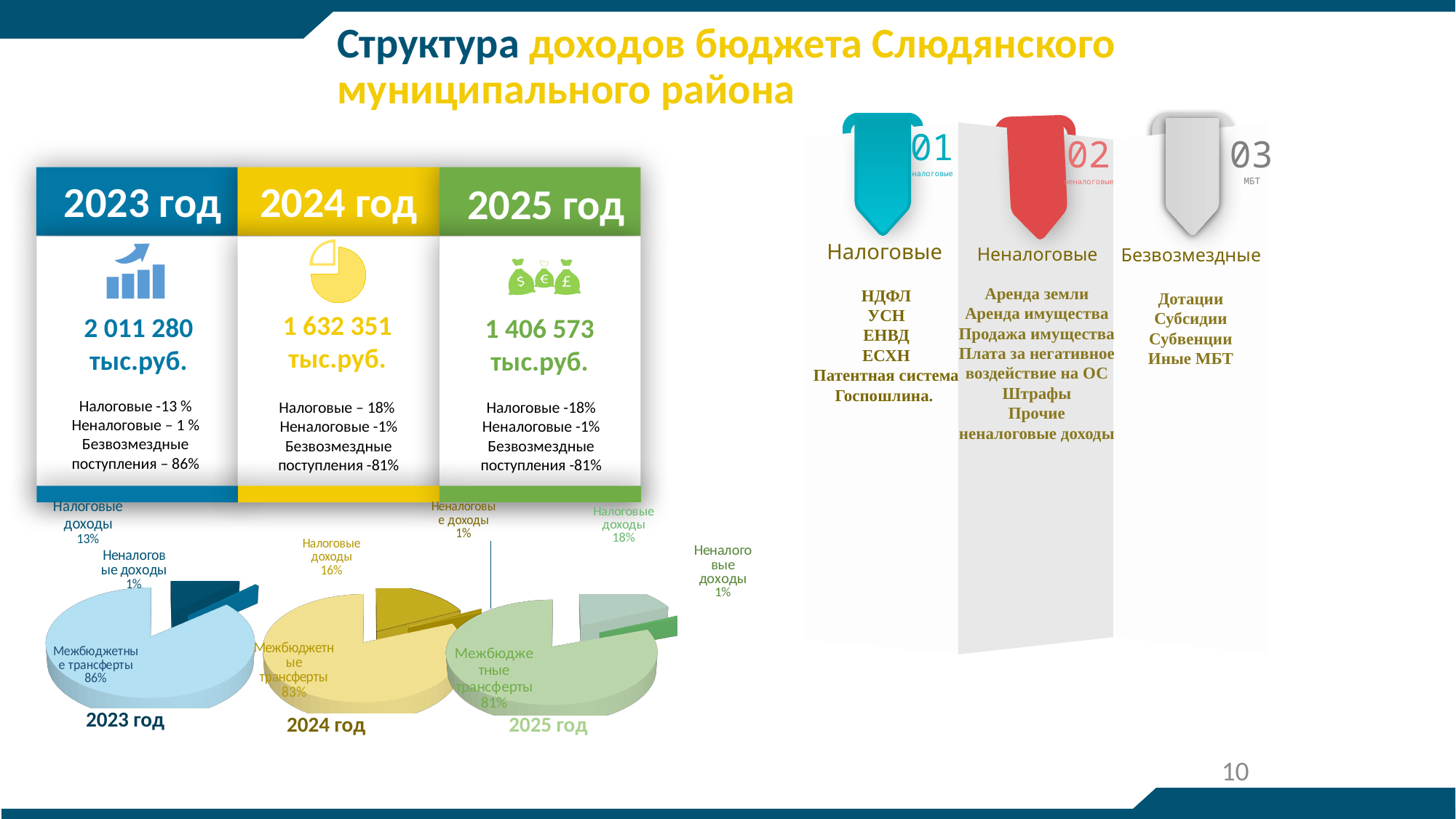
In the 2023 год pie chart, what share is labelled for Налоговые доходы? 13% In the 2024 год pie chart, which category has the smallest slice? Неналоговые доходы In the 2025 год pie chart, what share is labelled for Межбюджетные трансферты? 81% In the 2023 год pie chart, what share is labelled for Межбюджетные трансферты? 86% In the 2024 год pie chart, what share is labelled for Межбюджетные трансферты? 83% How many slices does the 2023 год pie chart have? 3 In the 2024 год pie chart, what share is labelled for Налоговые доходы? 16% Which is larger: the Налоговые доходы share in the 2025 год pie chart or in the 2023 год pie chart? 2025 год In the 2025 год pie chart, what share is labelled for Неналоговые доходы? 1% In the 2025 год pie chart, which category has the largest slice? Межбюджетные трансферты What type of chart is used to show the 2024 год income structure? Pie chart What is the difference between the Межбюджетные трансферты share in the 2023 год pie chart and in the 2025 год pie chart? 5 percentage points